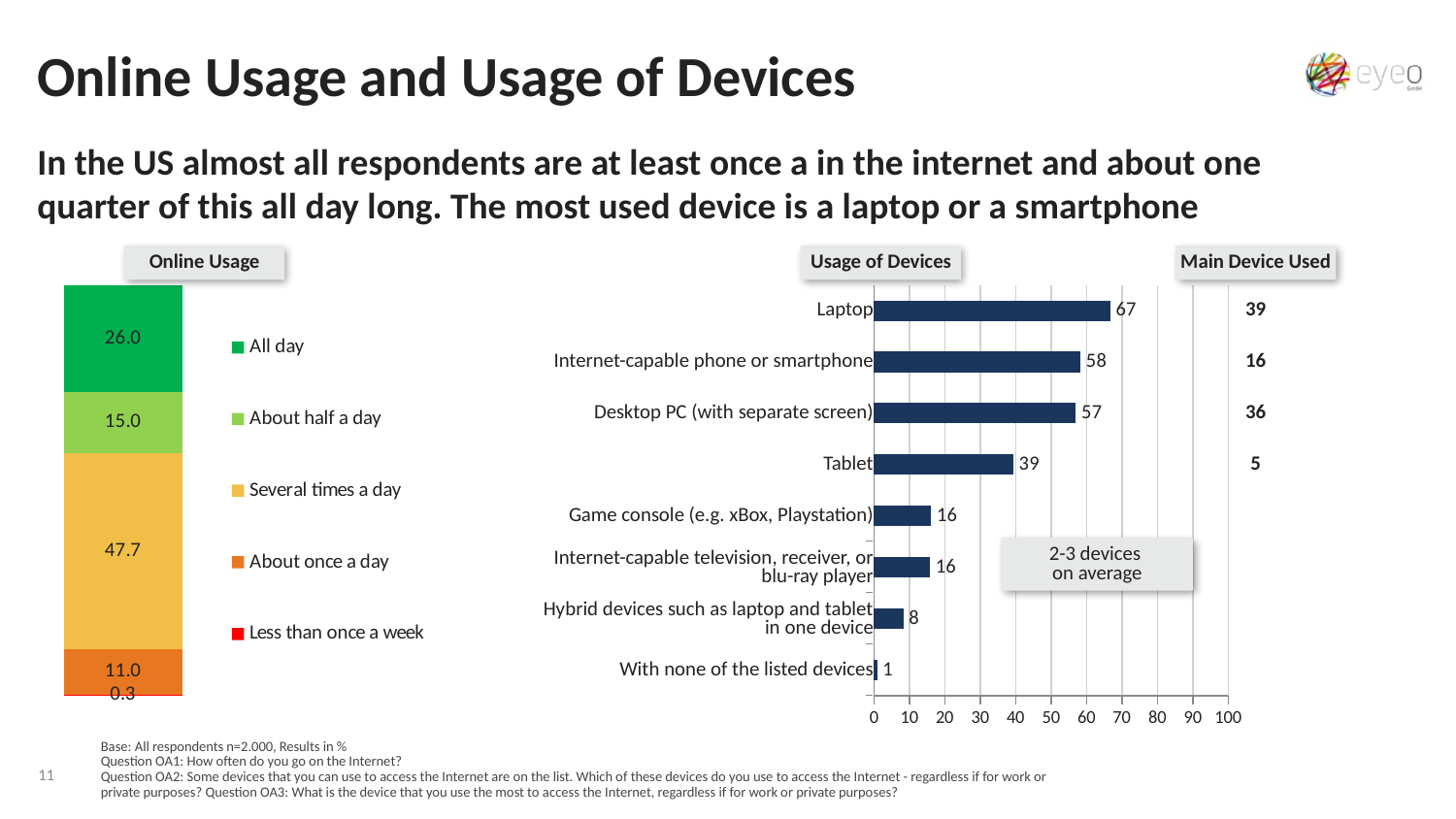
In the Usage of Devices chart, what is the difference between the values for Laptop and Tablet? 28 In the Online Usage chart, which category has the largest value? Several times a day How many entries does the legend of the Online Usage chart list? 5 In the Online Usage chart, what is the value for Several times a day? 47.7 In the Usage of Devices chart, which category has the lowest value? With none of the listed devices What kind of chart is the Usage of Devices chart? Bar chart In the Usage of Devices chart, what is the value for Laptop? 67 In the Usage of Devices chart, which device has the highest value? Laptop In the Online Usage chart, what is the value for All day? 26.0 In the Usage of Devices chart, which is larger: the value for Internet-capable phone or smartphone, or the value for Tablet? Internet-capable phone or smartphone In the Usage of Devices chart, what is the value for Tablet? 39 How many categories are shown in the Usage of Devices chart? 8